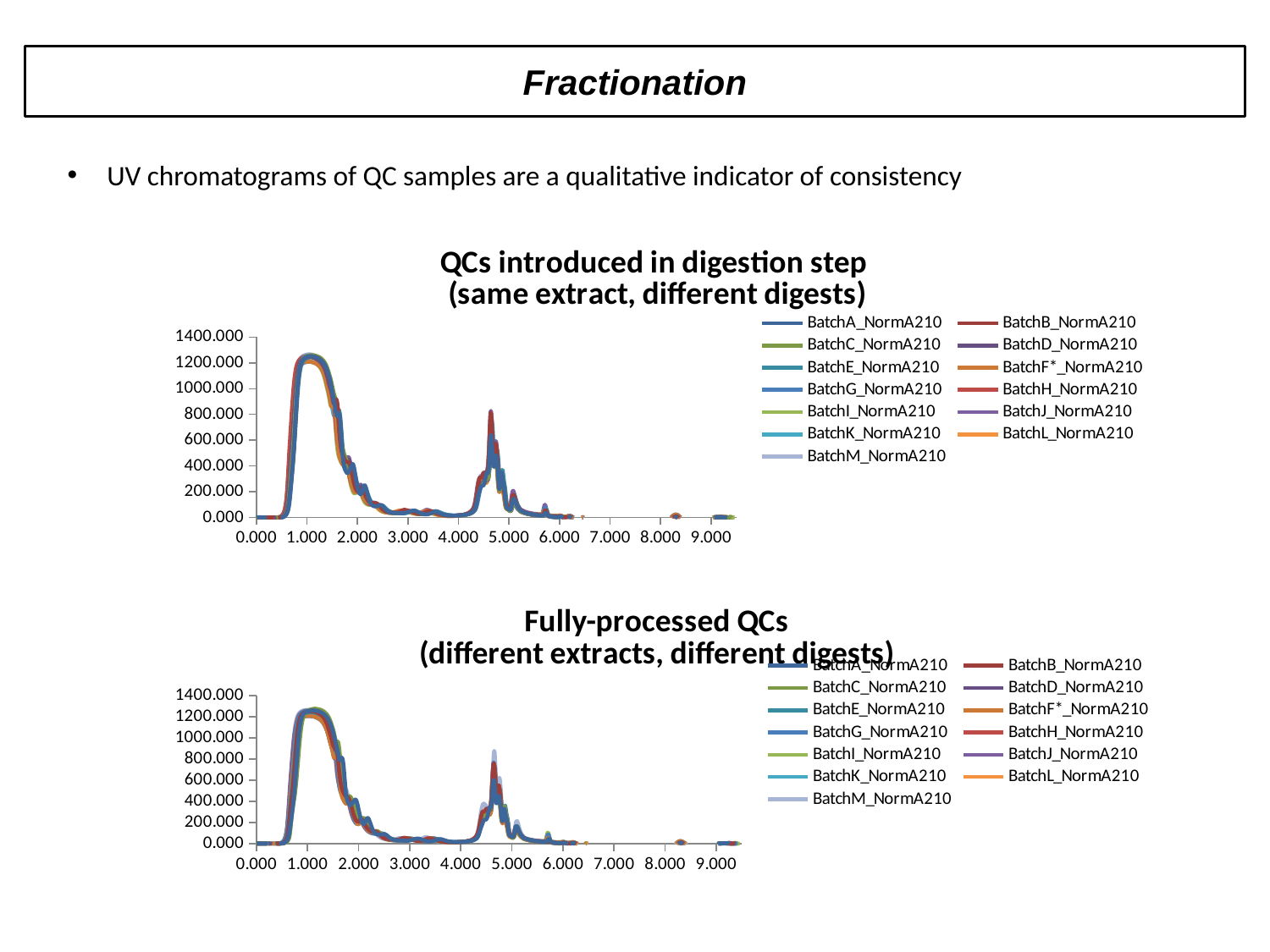
Which legend entry in the bottom chart (Fully-processed QCs) contains an asterisk? BatchF*_NormA210 In the top chart (QCs introduced in digestion step), is the maximum value of the first broad peak near x = 1.000 greater or less than 1000.000? greater In the bottom chart (Fully-processed QCs), is the highest value of the peak near x = 4.700 greater or less than 600.000? greater In the top chart (QCs introduced in digestion step), is the highest value of the peak near x = 4.700 greater or less than 600.000? greater What is the subtitle in parentheses of the top chart? (same extract, different digests) What kind of chart is the bottom chart titled "Fully-processed QCs"? line chart What kind of chart is the top chart titled "QCs introduced in digestion step"? line chart How many series does the legend of the bottom chart (Fully-processed QCs) list? 13 How many series does the legend of the top chart (QCs introduced in digestion step) list? 13